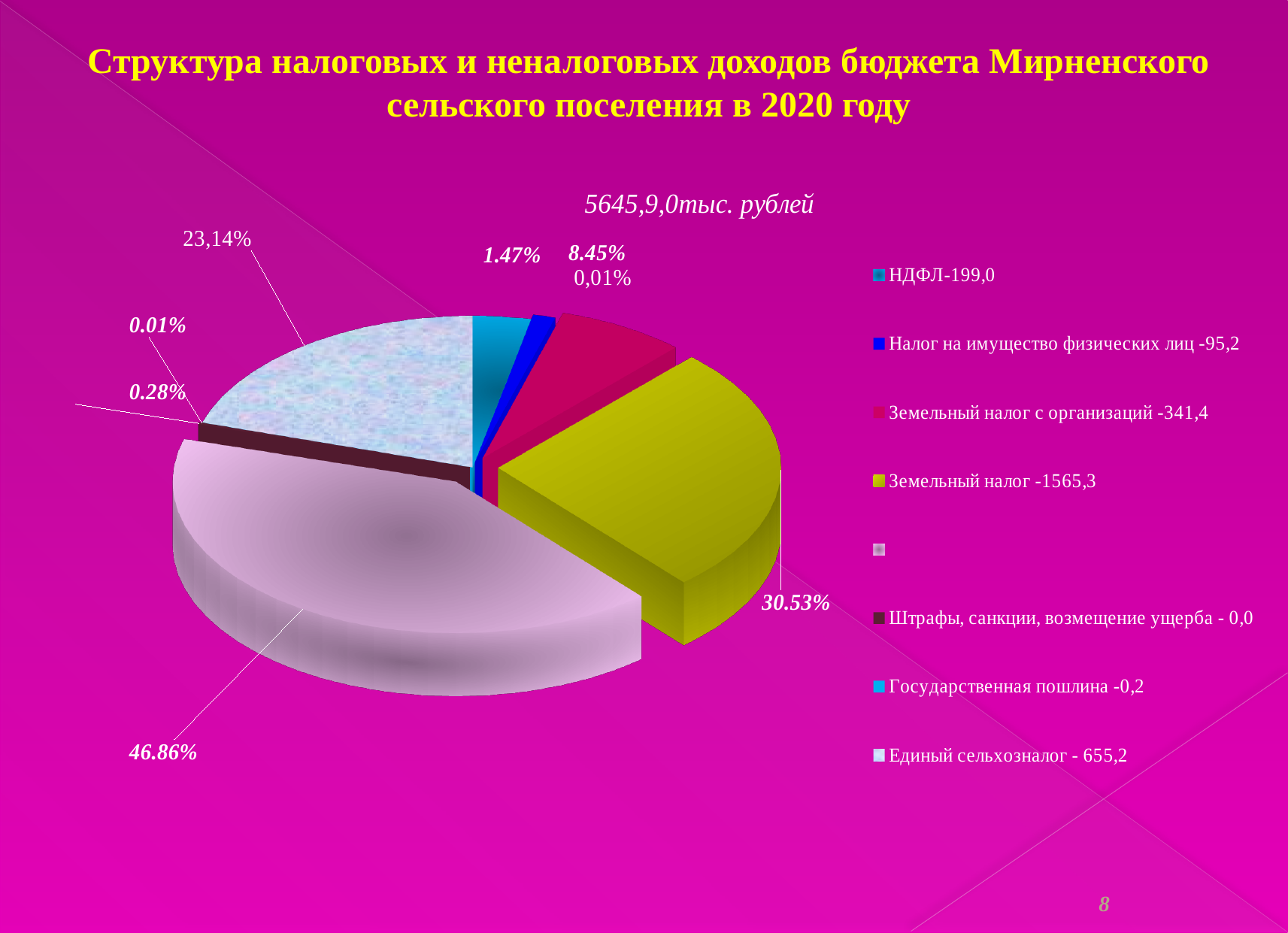
Which has the larger legend value: Земельный налог or Единый сельхозналог? Земельный налог What kind of chart is shown on the slide? pie chart According to the legend, what is the value for Земельный налог с организаций? 341,4 What percentage label is attached to the yellow slice (Земельный налог)? 30.53% According to the legend, what is the value for Штрафы, санкции, возмещение ущерба? 0,0 According to the legend, what is the value for НДФЛ? 199,0 According to the legend, what is the value for Налог на имущество физических лиц? 95,2 According to the legend, what is the value for Земельный налог? 1565,3 According to the legend, what is the value for Единый сельхозналог? 655,2 What percentage label is shown on the largest slice of the pie? 46.86% According to the legend, what is the value for Государственная пошлина? 0,2 What is the difference between the legend values for Земельный налог and Единый сельхозналог? 910,1